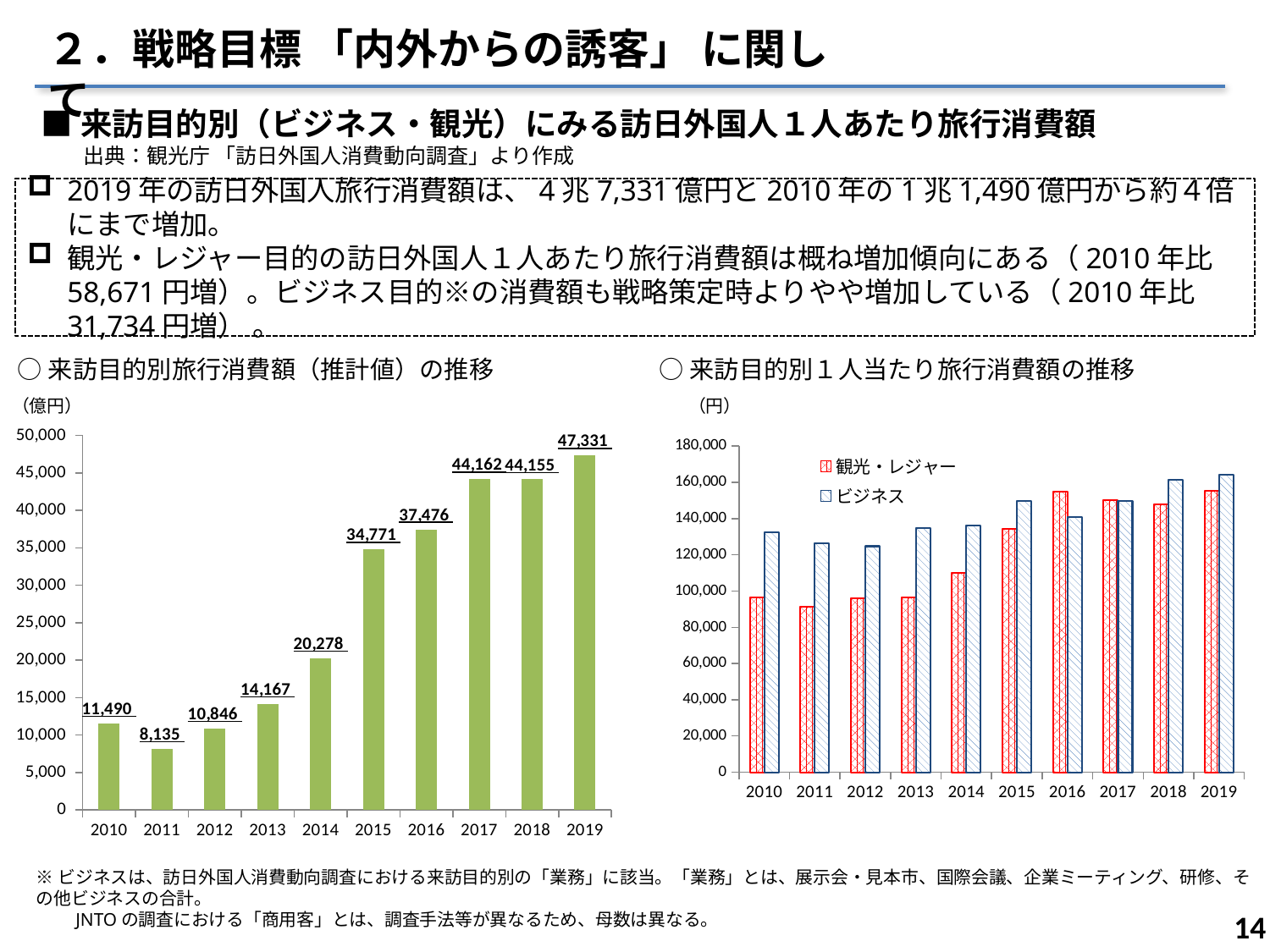
In the right chart (来訪目的別1人当たり旅行消費額の推移), is the 観光・レジャー value for 2010 greater or less than 100,000? less In the left chart (来訪目的別旅行消費額（推計値）の推移), how many years are plotted? 10 In the left chart (来訪目的別旅行消費額（推計値）の推移), which year has the lowest value? 2011 In the right chart (来訪目的別1人当たり旅行消費額の推移), which series has the larger value in 2010, 観光・レジャー or ビジネス? ビジネス In the left chart (来訪目的別旅行消費額（推計値）の推移), which year has the highest value? 2019 In the left chart (来訪目的別旅行消費額（推計値）の推移), what is the value for 2019? 47,331 In the left chart (来訪目的別旅行消費額（推計値）の推移), what is the difference between the 2019 value and the 2010 value? 35,841 What kind of chart is the right chart (来訪目的別1人当たり旅行消費額の推移)? bar chart In the right chart (来訪目的別1人当たり旅行消費額の推移), is the ビジネス value for 2019 greater or less than 160,000? greater In the left chart (来訪目的別旅行消費額（推計値）の推移), what is the value for 2014? 20,278 In the left chart (来訪目的別旅行消費額（推計値）の推移), what unit is shown on the axis label? 億円 In the right chart (来訪目的別1人当たり旅行消費額の推移), how many series does the legend list? 2